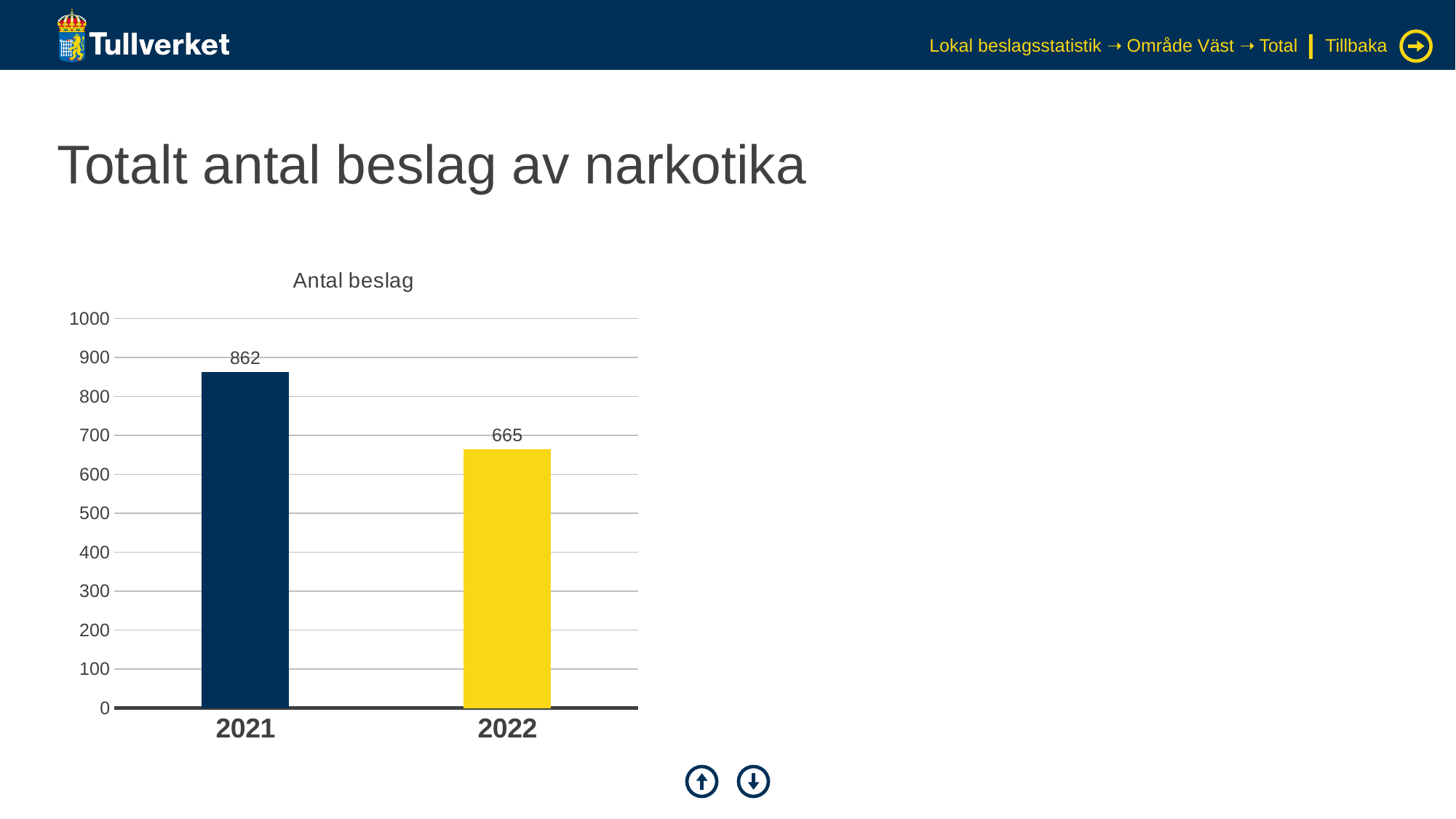
Is the value for 2021 greater or less than 800? greater Do the values rise or fall from 2021 to 2022? fall How many categories are shown on the x axis? 2 Which is larger, the value for 2021 or the value for 2022? 2021 What kind of chart is shown? bar chart Which year has the highest value? 2021 What is the title of the chart? Antal beslag Which year has the lowest value? 2022 Is the value for 2022 greater or less than 700? less What is the difference between the values for 2021 and 2022? 197 What is the value for 2021? 862 What is the value for 2022? 665